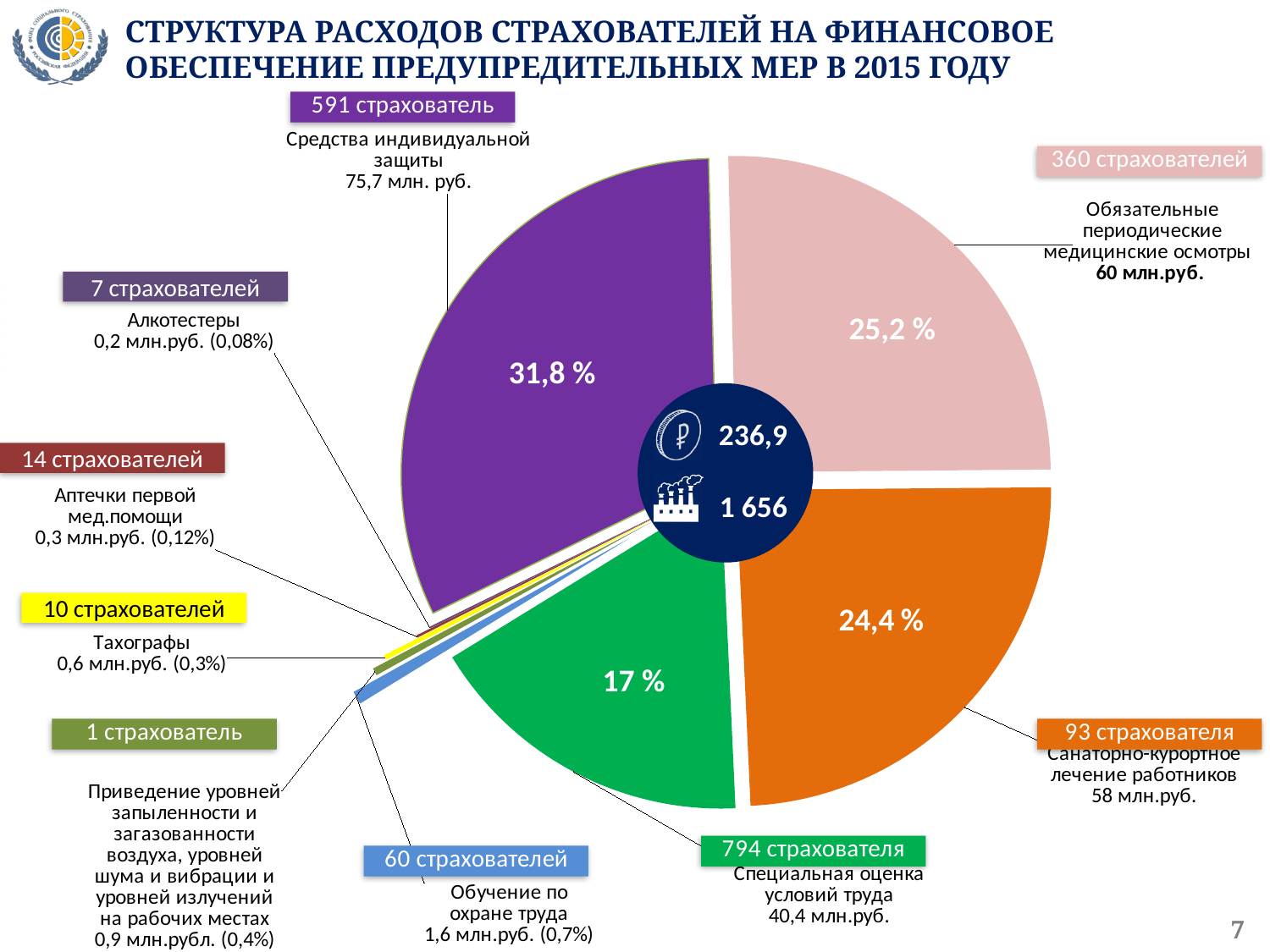
How many slices does the pie chart have? 9 What share of the pie does "Специальная оценка условий труда" have? 17 % Which category has the largest slice of the pie? Средства индивидуальной защиты What share of the pie does "Санаторно-курортное лечение работников" have? 24,4 % What share of the pie does "Средства индивидуальной защиты" have? 31,8 % What is the amount in млн. руб. for "Средства индивидуальной защиты"? 75,7 млн. руб. What is the amount for "Обучение по охране труда"? 1,6 млн.руб. What is the difference in percentage points between the shares of "Средства индивидуальной защиты" and "Санаторно-курортное лечение работников"? 7,4 Which is larger: the share for "Обязательные периодические медицинские осмотры" or for "Специальная оценка условий труда"? Обязательные периодические медицинские осмотры Which category has the smallest slice of the pie? Алкотестеры What kind of chart is shown on the slide? pie chart